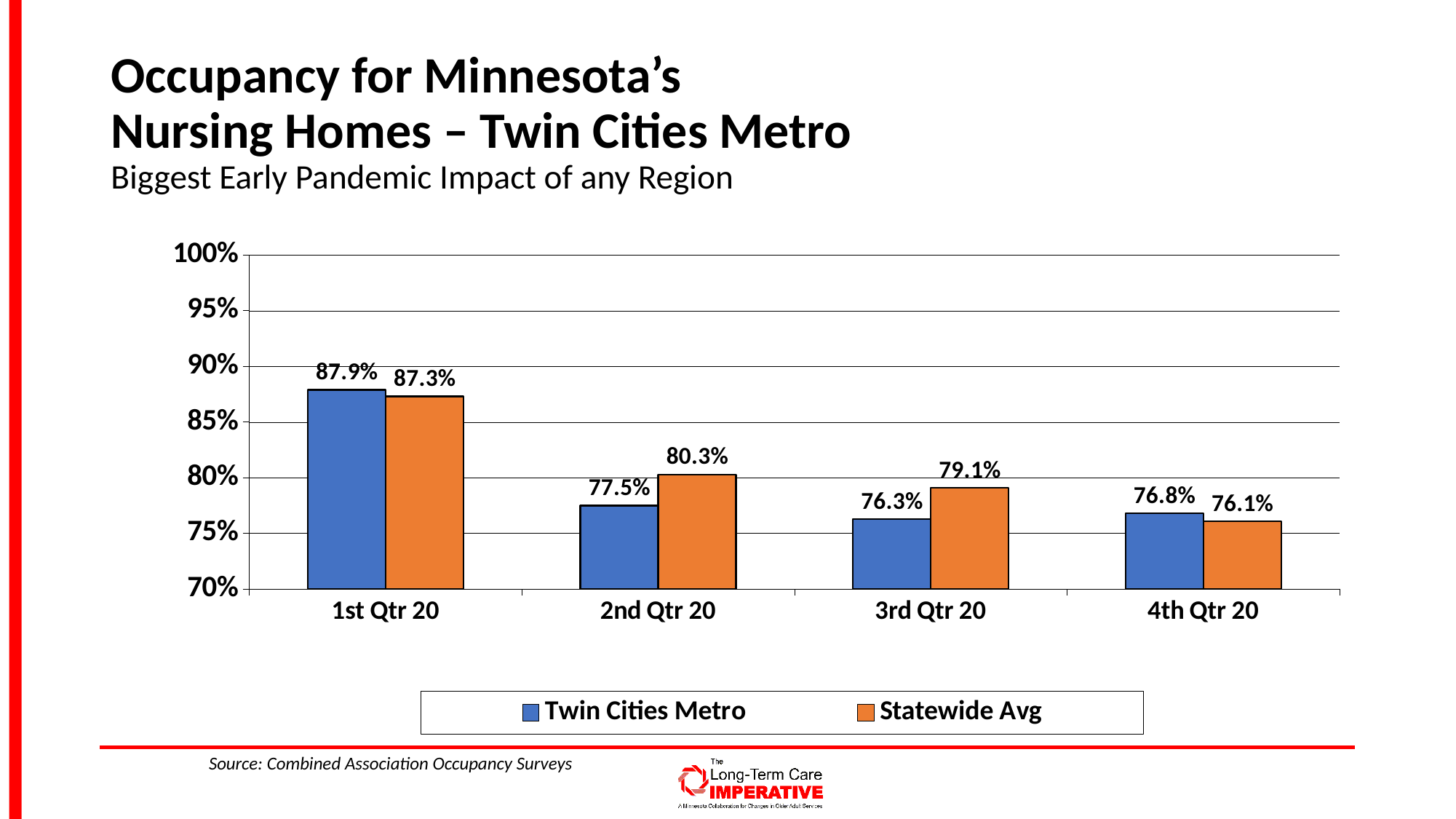
What is the Statewide Avg occupancy value for 2nd Qtr 20? 80.3% How many quarters are shown on the x axis? 4 Does the Statewide Avg occupancy rise or fall from 1st Qtr 20 to 4th Qtr 20? Fall In which quarter is the Statewide Avg occupancy highest? 1st Qtr 20 What is the Twin Cities Metro occupancy value for 1st Qtr 20? 87.9% What kind of chart is shown on the slide? Bar chart Which is larger in 2nd Qtr 20, Twin Cities Metro or Statewide Avg? Statewide Avg What is the difference between the Twin Cities Metro values for 1st Qtr 20 and 2nd Qtr 20? 10.4% What is the Twin Cities Metro occupancy value for 4th Qtr 20? 76.8% What is the difference between the Statewide Avg and Twin Cities Metro values in 3rd Qtr 20? 2.8% How many series does the legend list? 2 In which quarter is the Twin Cities Metro occupancy lowest? 3rd Qtr 20